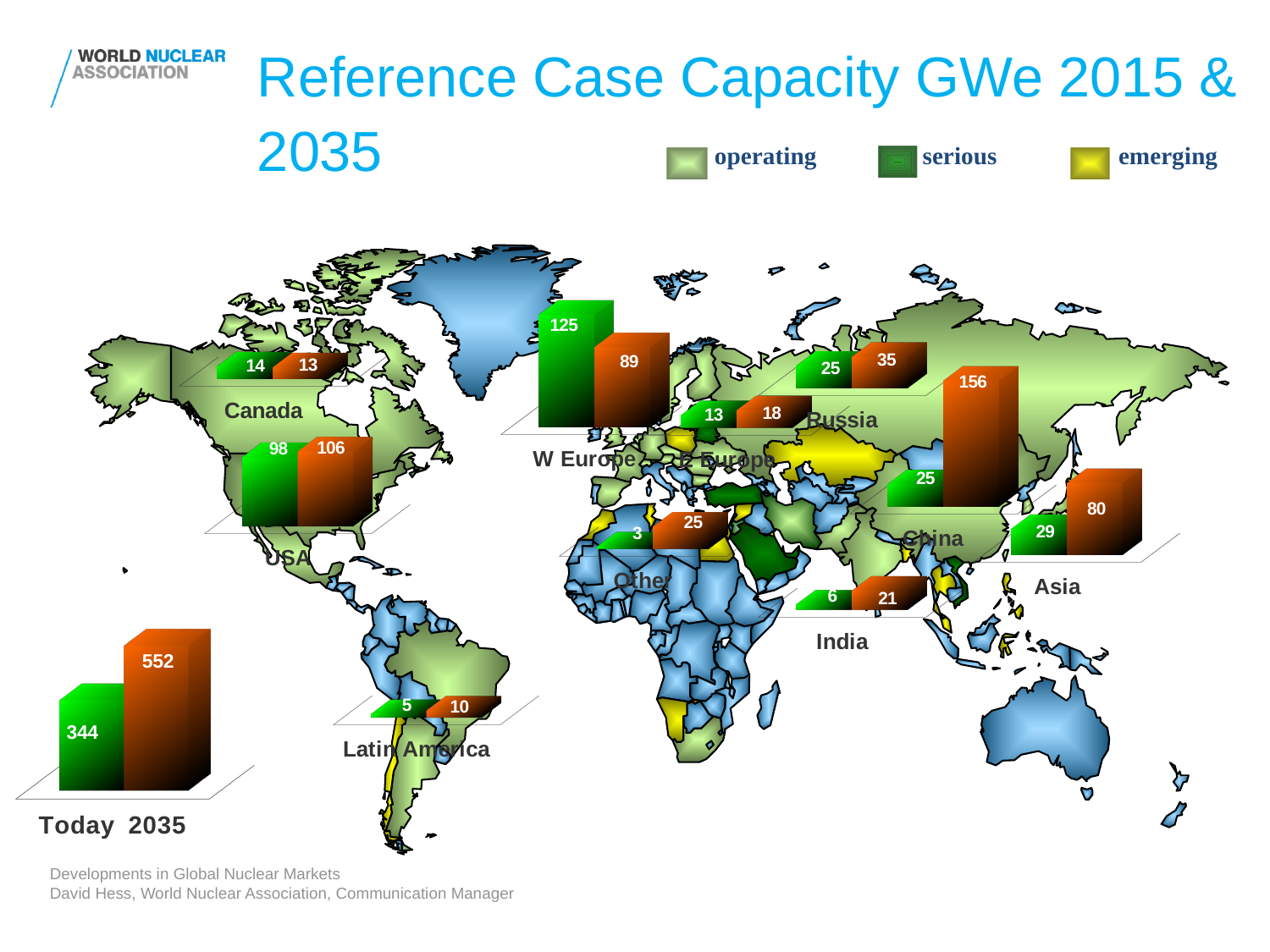
On the world map chart, what is the 2035 capacity value shown for China? 156 On the world map chart, which is larger for W Europe: the Today value or the 2035 value? Today What kind of chart is used to show the capacity values on the slide? bar chart In the world total bar chart at the bottom left (Today / 2035), what is the 2035 value? 552 On the world map chart, what is the difference between the 2035 and Today values for Asia? 51 On the world map chart, which region has the highest 2035 capacity value? China In the world total bar chart at the bottom left, what is the difference between the 2035 value and the Today value? 208 On the world map chart, which region has the lowest Today (2015) capacity value? Other On the world map chart, what is the 2035 capacity value shown for India? 21 On the world map chart, what is the Today (2015) capacity value shown for the USA? 98 How many regions on the world map chart have a pair of capacity bars? 10 On the world map chart, what is the Today (2015) capacity value shown for W Europe? 125